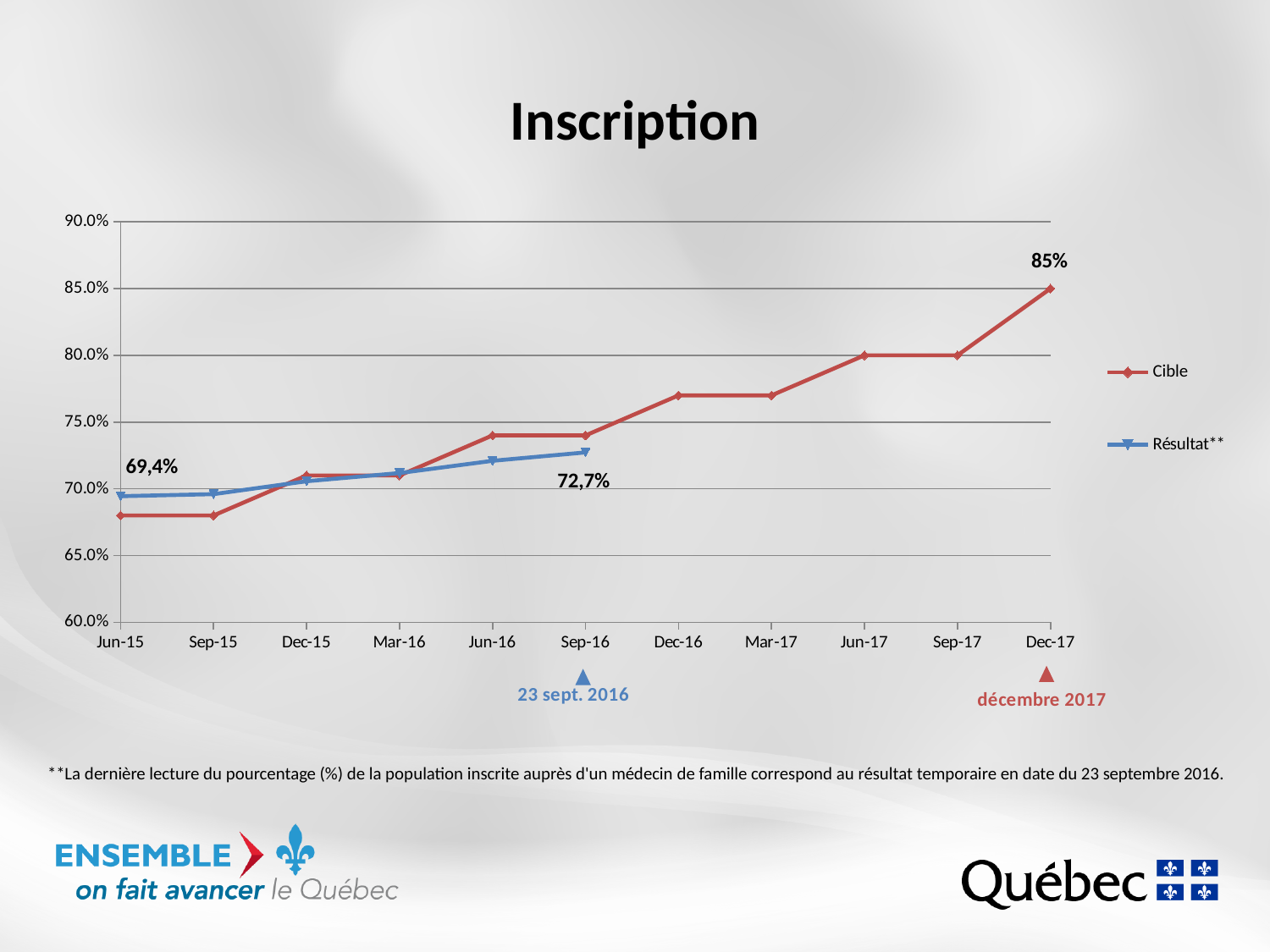
Is the value of Cible at Dec-16 greater or less than 75.0%? greater What is the value of Résultat** at Jun-15? 69,4% What are the two series named in the legend? Cible and Résultat** How many dates are shown on the x axis? 11 What is the value of Résultat** at Sep-16? 72,7% What kind of chart is shown on the slide? line chart What is the value of Cible at Dec-17? 85% Does the Cible series rise or fall from Jun-15 to Dec-17? rise How many series does the legend list? 2 By how many percentage points did Résultat** increase from Jun-15 to Sep-16? 3,3 At which date does the Cible series reach its highest value? Dec-17 Is the value of Cible at Jun-15 greater or less than 70.0%? less